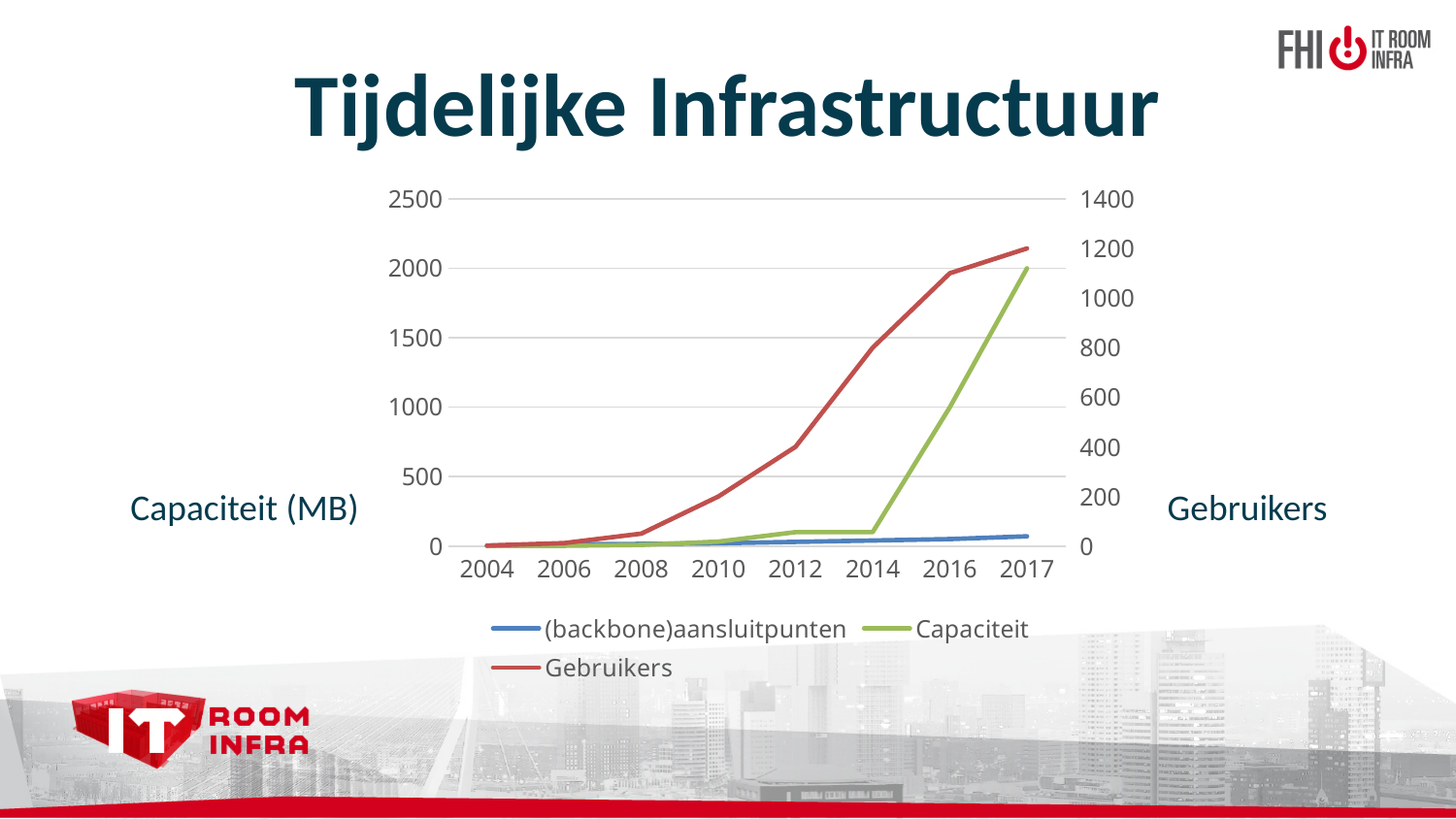
What kind of chart is shown on the slide? line chart Is the Capaciteit value for 2017 greater or less than 1500 on the left axis? greater Is the Capaciteit value for 2014 greater or less than 500 on the left axis? less What colour is the Capaciteit line? green How many series does the legend list? 3 Does the Gebruikers line rise or fall from 2004 to 2017? rise Which series is plotted lowest across the whole chart? (backbone)aansluitpunten How many years are shown on the x axis? 8 What is the label of the left vertical axis? Capaciteit (MB) Which is larger, the Capaciteit value for 2014 or for 2017? 2017 Is the Gebruikers value for 2017 greater or less than 1000 on the right axis? greater